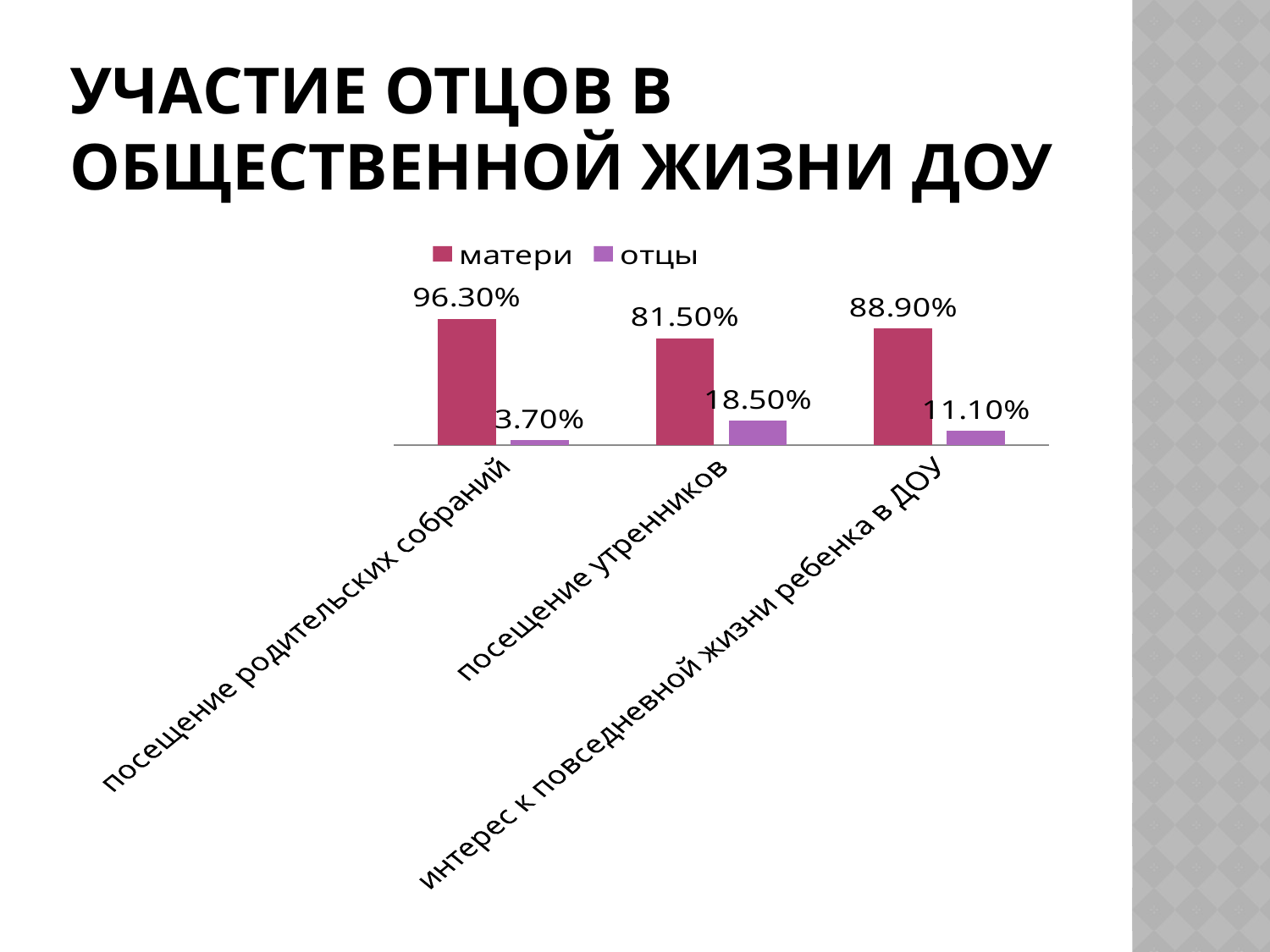
What kind of chart is shown on the slide? bar chart What is the difference between матери and отцы for посещение родительских собраний? 92.60% How many series does the legend list? 2 How many categories are shown on the x axis? 3 What is the value for матери for посещение родительских собраний? 96.30% Which category has the lowest value for матери? посещение утренников What is the value for отцы for интерес к повседневной жизни ребенка в ДОУ? 11.10% Which category has the highest value for отцы? посещение утренников What are the two series named in the legend? матери and отцы Which is larger for интерес к повседневной жизни ребенка в ДОУ: матери or отцы? матери What is the value for отцы for посещение утренников? 18.50% What is the value for матери for посещение утренников? 81.50%